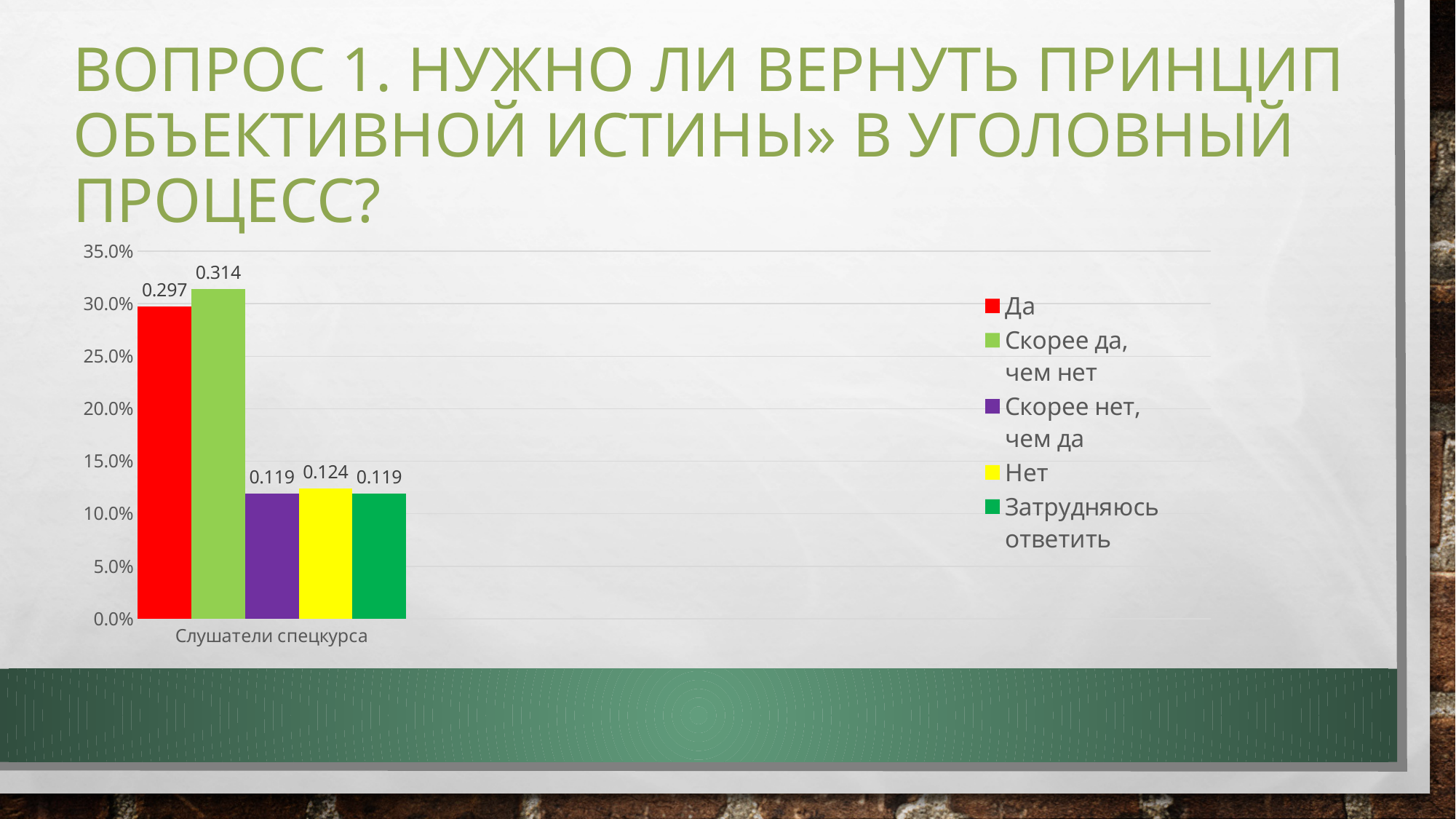
What is the category label shown on the x axis? Слушатели спецкурса What is the value for the series "Да"? 0.297 What is the value for the series "Затрудняюсь ответить"? 0.119 Which is larger, the value for "Да" or the value for "Нет"? Да What type of chart is shown on the slide? bar chart What is the value for the series "Нет"? 0.124 How many series does the legend list? 5 What is the difference between the values for "Скорее да, чем нет" and "Да"? 0.017 Is the value for "Да" greater or less than 25.0%? greater What is the value for the series "Скорее да, чем нет"? 0.314 Which series has the highest value? Скорее да, чем нет What colour is the bar for the series "Нет"? yellow